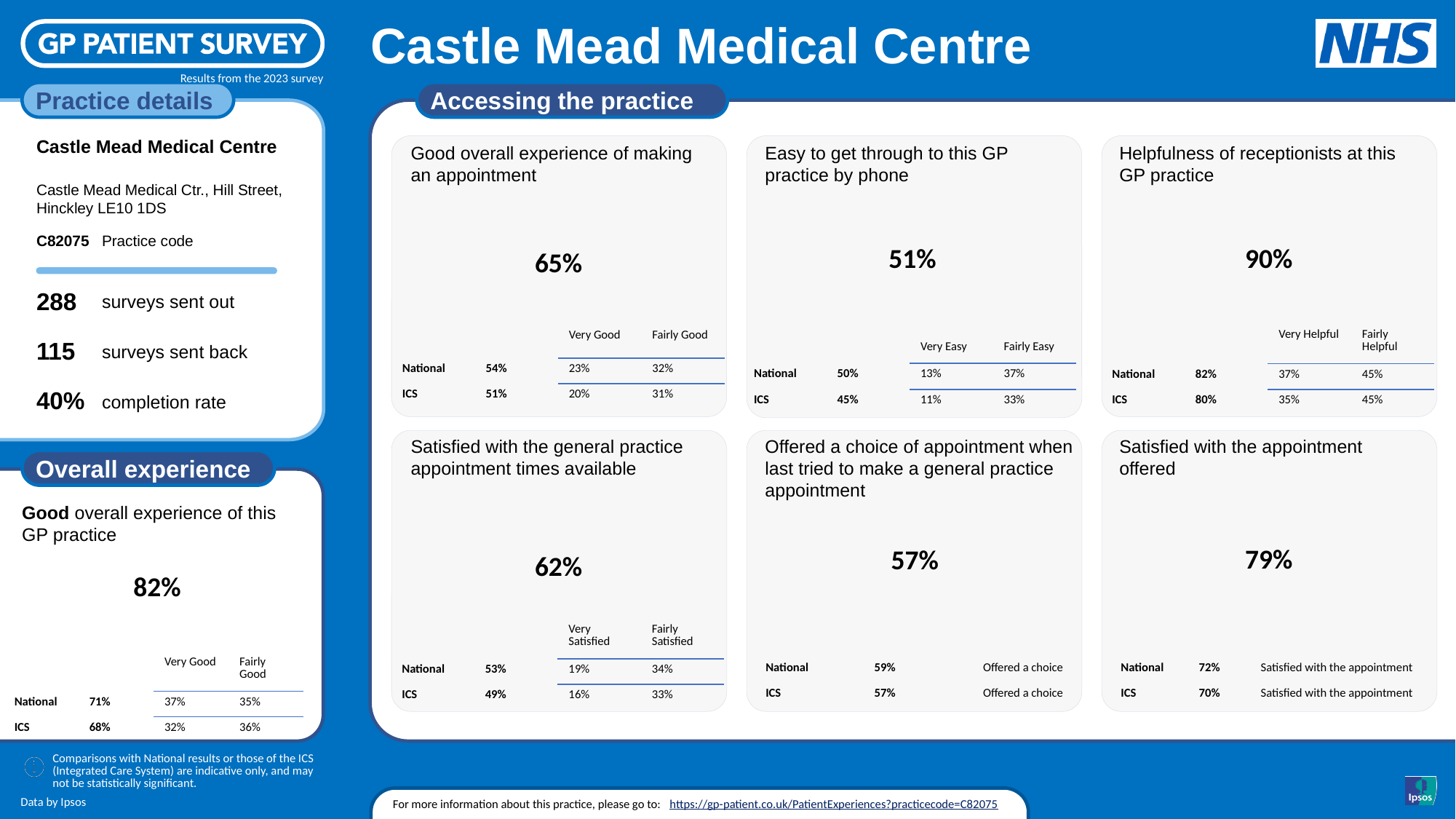
In the 'Satisfied with the appointment offered' panel, what is the difference between the practice's headline value and the National value? 7% In the 'Satisfied with the general practice appointment times available' panel, what is the National value for Fairly Satisfied? 34% In the 'Good overall experience of this GP practice' panel, what is the ICS value for Very Good? 32% Across the six 'Accessing the practice' panels, which measure has the lowest headline percentage for the practice? Easy to get through to this GP practice by phone In the 'Good overall experience of making an appointment' panel, what is the difference between the National and ICS values for Very Good? 3% In the 'Helpfulness of receptionists at this GP practice' panel, what is the ICS value for Very Helpful? 35% In the 'Good overall experience of making an appointment' panel, what is the headline percentage for the practice? 65% In the 'Easy to get through to this GP practice by phone' panel, what is the National value? 50% How many measure panels are shown under the 'Accessing the practice' heading? 6 In the 'Easy to get through to this GP practice by phone' panel, which is larger: the National value or the ICS value? National Across the six 'Accessing the practice' panels, which measure has the highest headline percentage for the practice? Helpfulness of receptionists at this GP practice In the 'Offered a choice of appointment when last tried to make a general practice appointment' panel, what is the ICS value? 57%